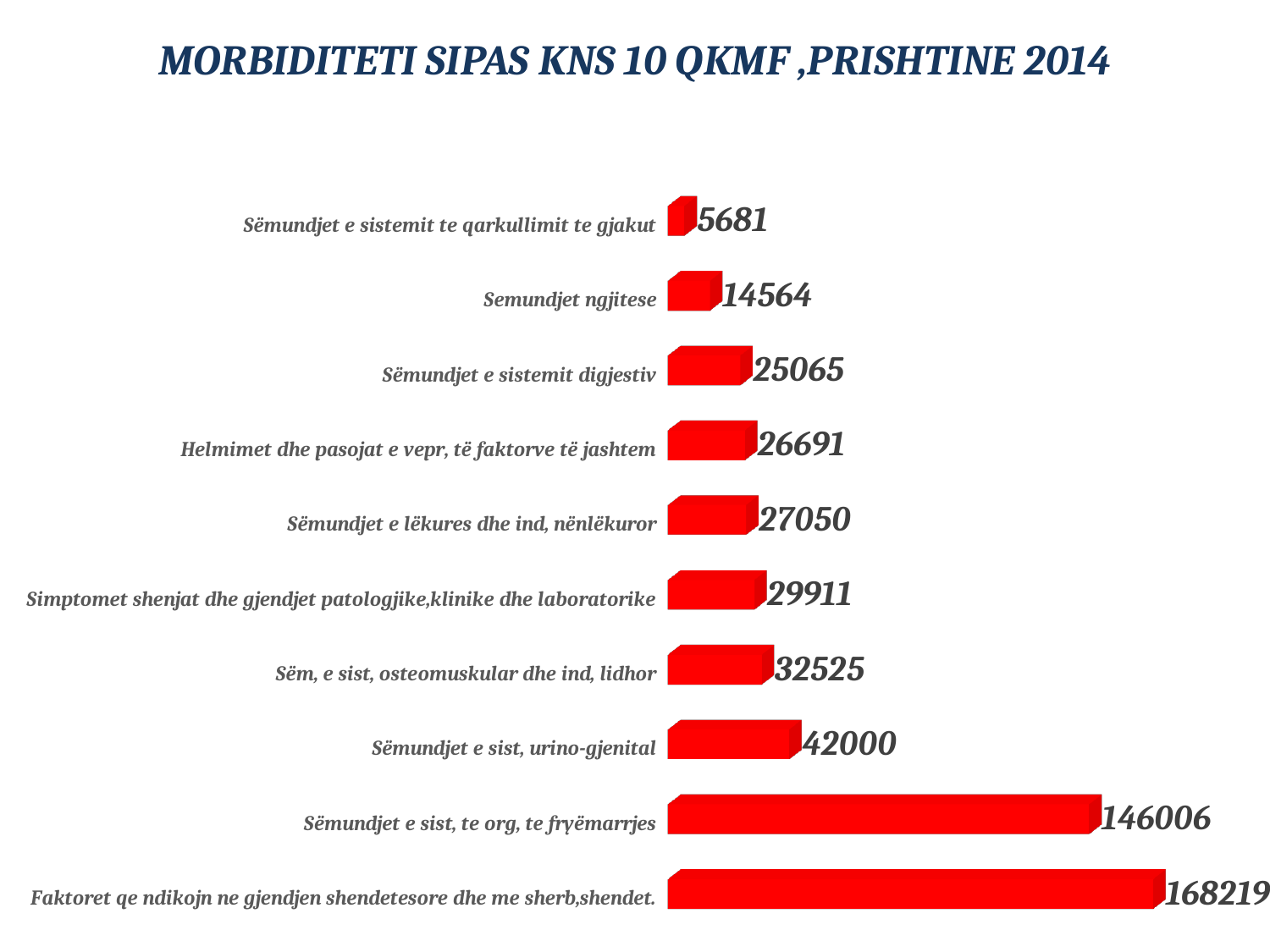
What is the value for Sëmundjet e sist, urino-gjenital? 42000 What colour are the bars in the chart? red What is the difference between the values for Sëm, e sist, osteomuskular dhe ind, lidhor and Sëmundjet e sistemit digjestiv? 7460 What is the value for Sëmundjet e sist, te org, te fryëmarrjes? 146006 Which is larger: the value for Sëmundjet e sist, urino-gjenital or the value for Simptomet shenjat dhe gjendjet patologjike,klinike dhe laboratorike? Sëmundjet e sist, urino-gjenital What is the title of the chart? MORBIDITETI SIPAS KNS 10 QKMF ,PRISHTINE 2014 What is the difference between the values for Faktoret qe ndikojn ne gjendjen shendetesore dhe me sherb,shendet. and Sëmundjet e sist, te org, te fryëmarrjes? 22213 What kind of chart is shown on the slide? bar chart How many categories are shown in the chart? 10 Which category has the lowest value? Sëmundjet e sistemit te qarkullimit te gjakut Which category has the highest value? Faktoret qe ndikojn ne gjendjen shendetesore dhe me sherb,shendet. What is the value for Semundjet ngjitese? 14564